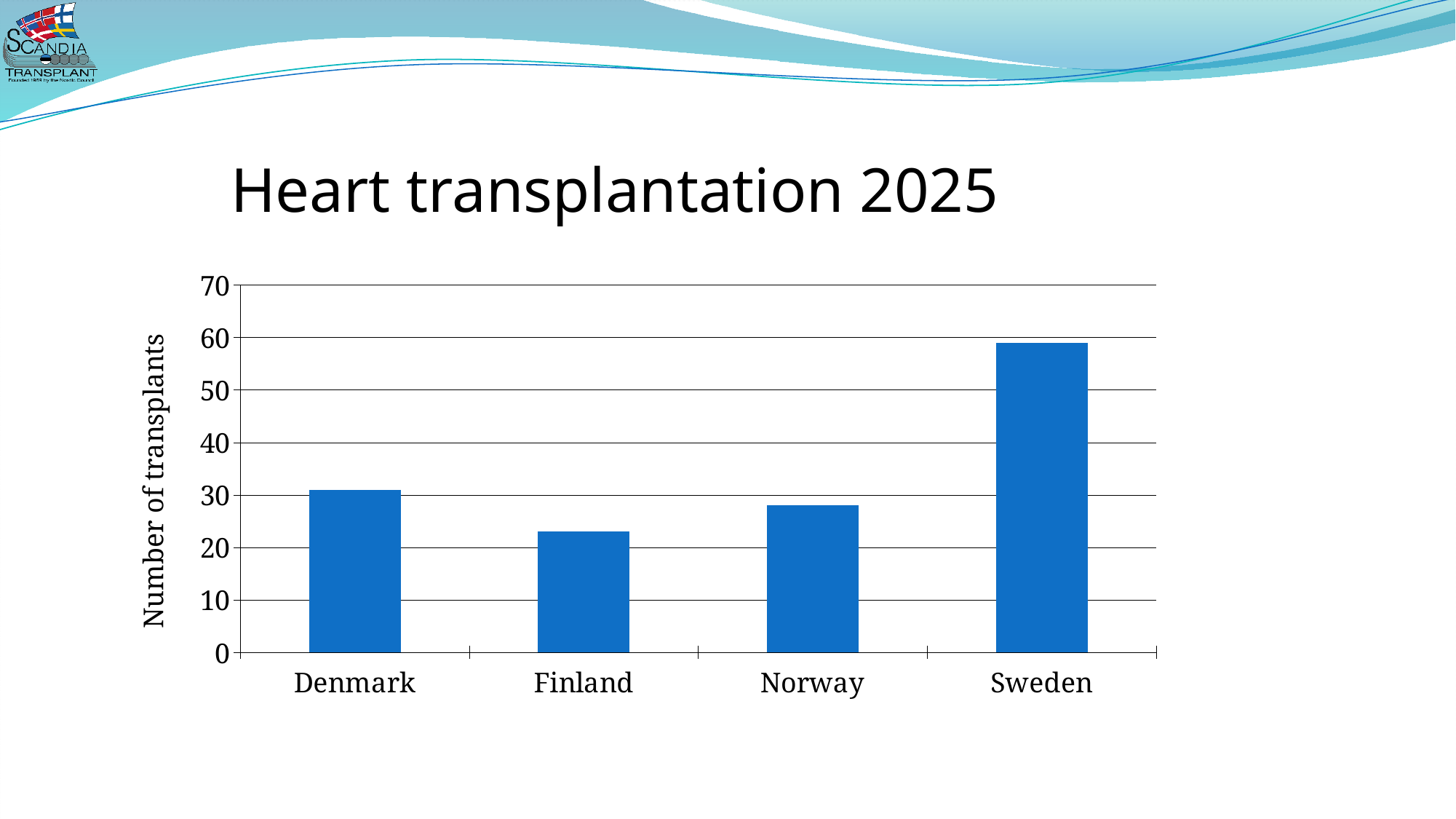
What is the label on the vertical axis of the chart? Number of transplants Which country has the lowest number of heart transplants in the chart? Finland What type of chart is shown on the slide? bar chart Which country has the highest number of heart transplants in the chart? Sweden Is the value for Finland greater or less than 30? less Which has more heart transplants, Sweden or Denmark? Sweden Is the value for Norway greater or less than 30? less How many countries are shown on the x axis of the chart? 4 Is the value for Sweden greater or less than 50? greater Which has more heart transplants, Norway or Finland? Norway